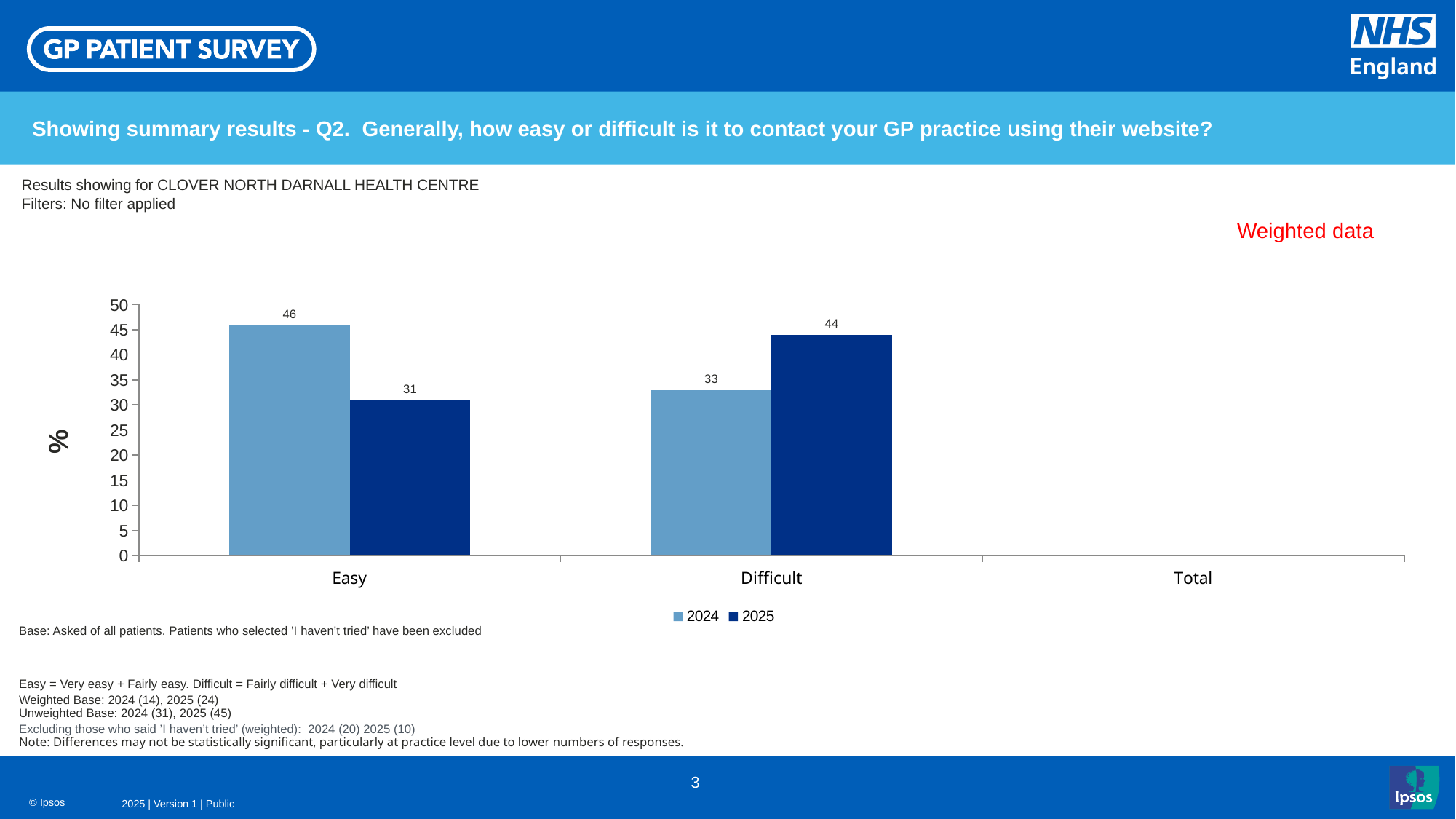
What is the difference between the 2025 and 2024 values for Difficult? 11 What label is shown on the vertical axis? % What is the 2025 value for Easy? 31 Which category has the highest 2024 value? Easy Which is larger for Difficult, the 2024 value or the 2025 value? 2025 What kind of chart is shown on the slide? Bar chart How many series does the legend list? 2 Which category has the lowest 2025 value? Easy What is the 2025 value for Difficult? 44 What is the difference between the 2024 and 2025 values for Easy? 15 What is the 2024 value for Difficult? 33 What is the 2024 value for Easy? 46